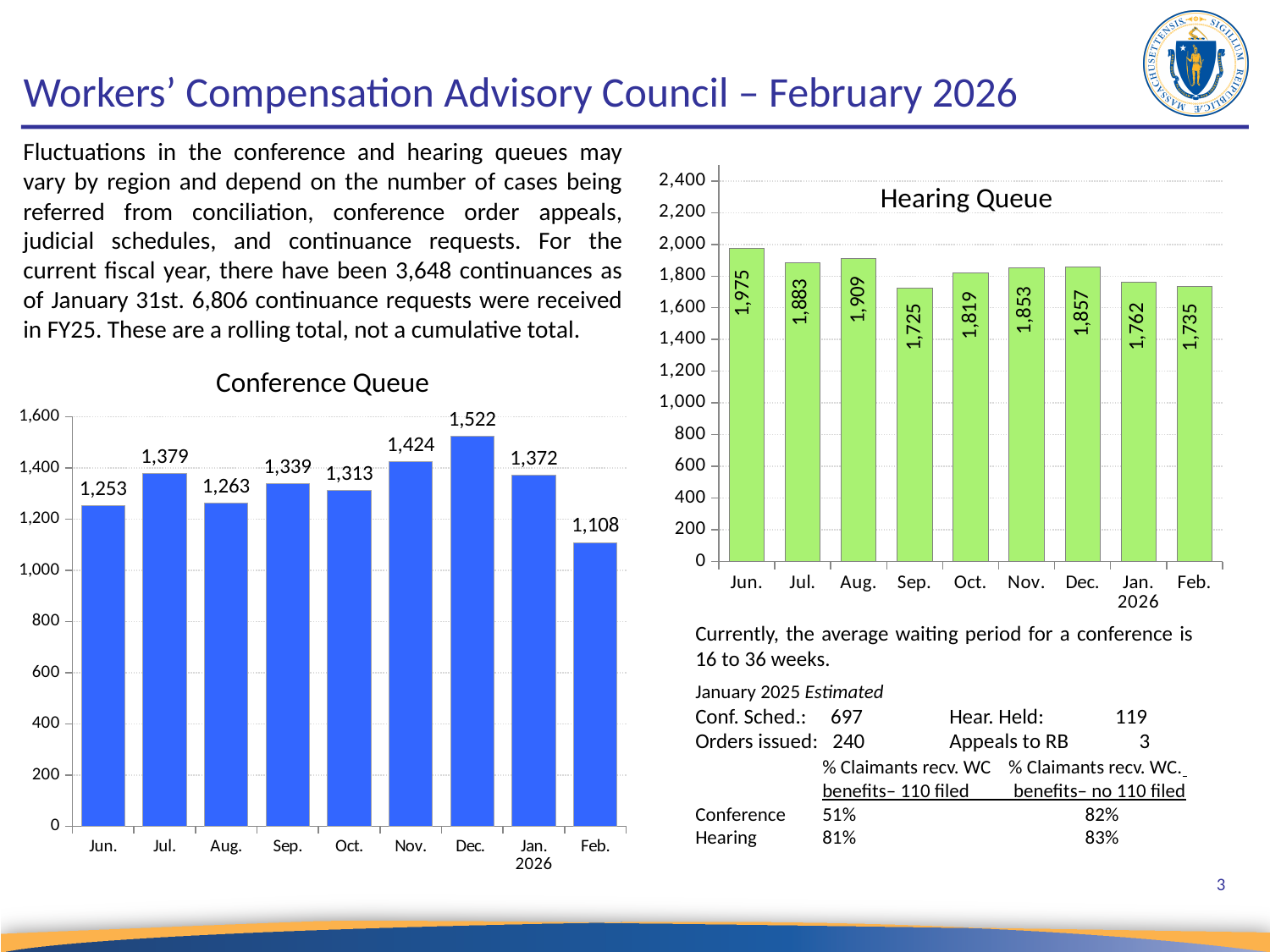
In the Conference Queue chart, which month has the lowest value? Feb. What kind of chart is the Hearing Queue chart? bar chart In the Conference Queue chart, what is the value for Dec.? 1,522 In the Hearing Queue chart, do the values rise or fall from Dec. to Feb.? fall In the Conference Queue chart, how many months are plotted? 9 In the Hearing Queue chart, what is the value for Sep.? 1,725 In the Hearing Queue chart, which is larger, the value for Aug. or the value for Oct.? Aug. In the Hearing Queue chart, what is the difference between the Jun. and Feb. values? 240 In the Conference Queue chart, what is the difference between the Dec. and Feb. values? 414 What colour are the bars in the Conference Queue chart? blue In the Conference Queue chart, is the value for Jul. greater or less than 1,400? less In the Hearing Queue chart, which month has the highest value? Jun.